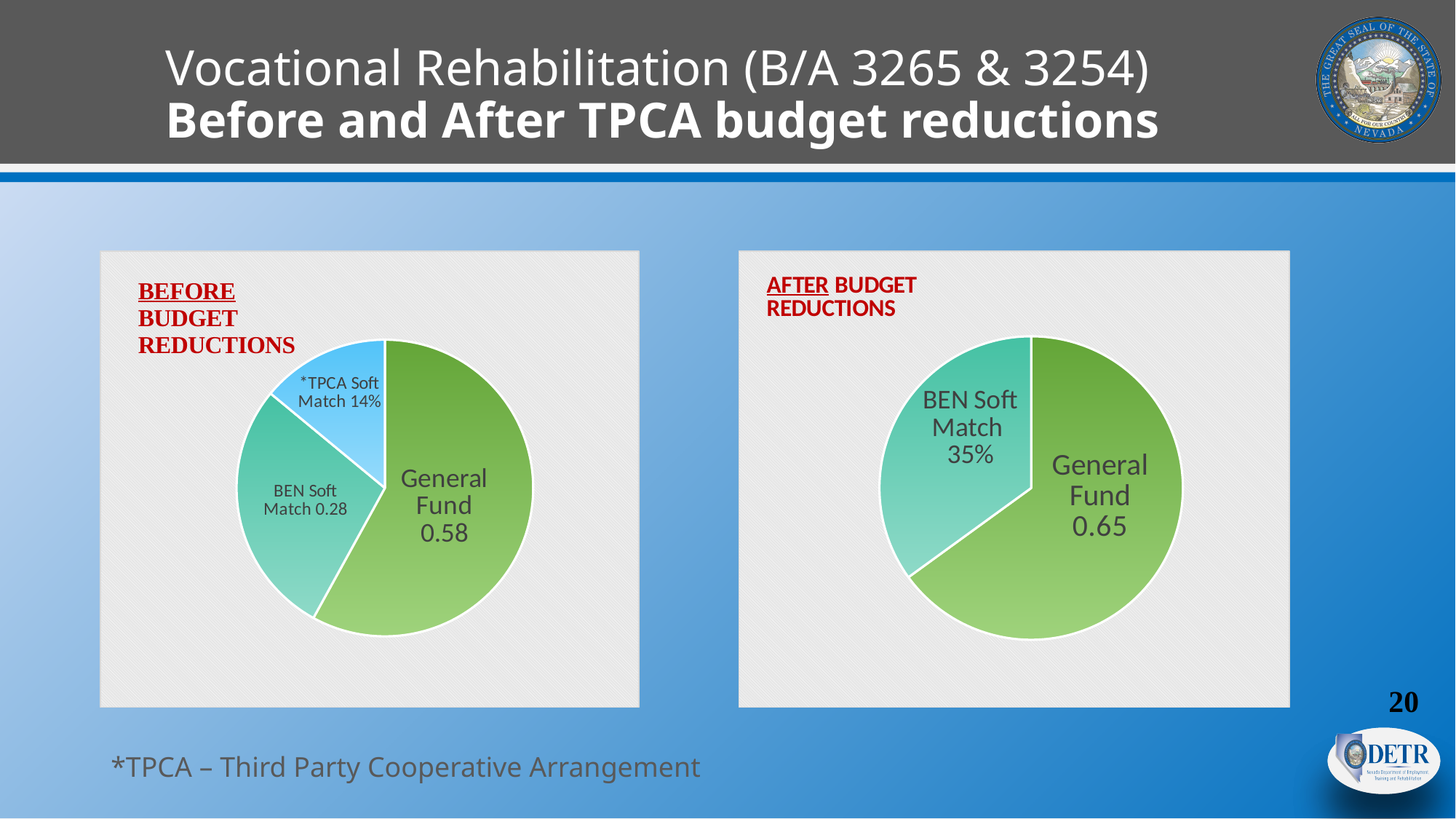
In the 'Before Budget Reductions' pie chart, which slice is the largest? General Fund In the 'After Budget Reductions' pie chart, what is the value shown for General Fund? 0.65 How many slices does the 'After Budget Reductions' pie chart have? 2 How many slices does the 'Before Budget Reductions' pie chart have? 3 In the 'Before Budget Reductions' pie chart, what share is shown for TPCA Soft Match? 14% In the 'After Budget Reductions' pie chart, which slice is larger, General Fund or BEN Soft Match? General Fund In the 'After Budget Reductions' pie chart, what share is shown for BEN Soft Match? 35% In the 'Before Budget Reductions' pie chart, what is the value shown for BEN Soft Match? 0.28 What type of chart is used in the 'After Budget Reductions' panel? Pie chart In the 'Before Budget Reductions' pie chart, what is the value shown for General Fund? 0.58 In the 'Before Budget Reductions' pie chart, which slice is the smallest? *TPCA Soft Match In the 'Before Budget Reductions' pie chart, what is the difference between the General Fund value and the BEN Soft Match value? 0.30